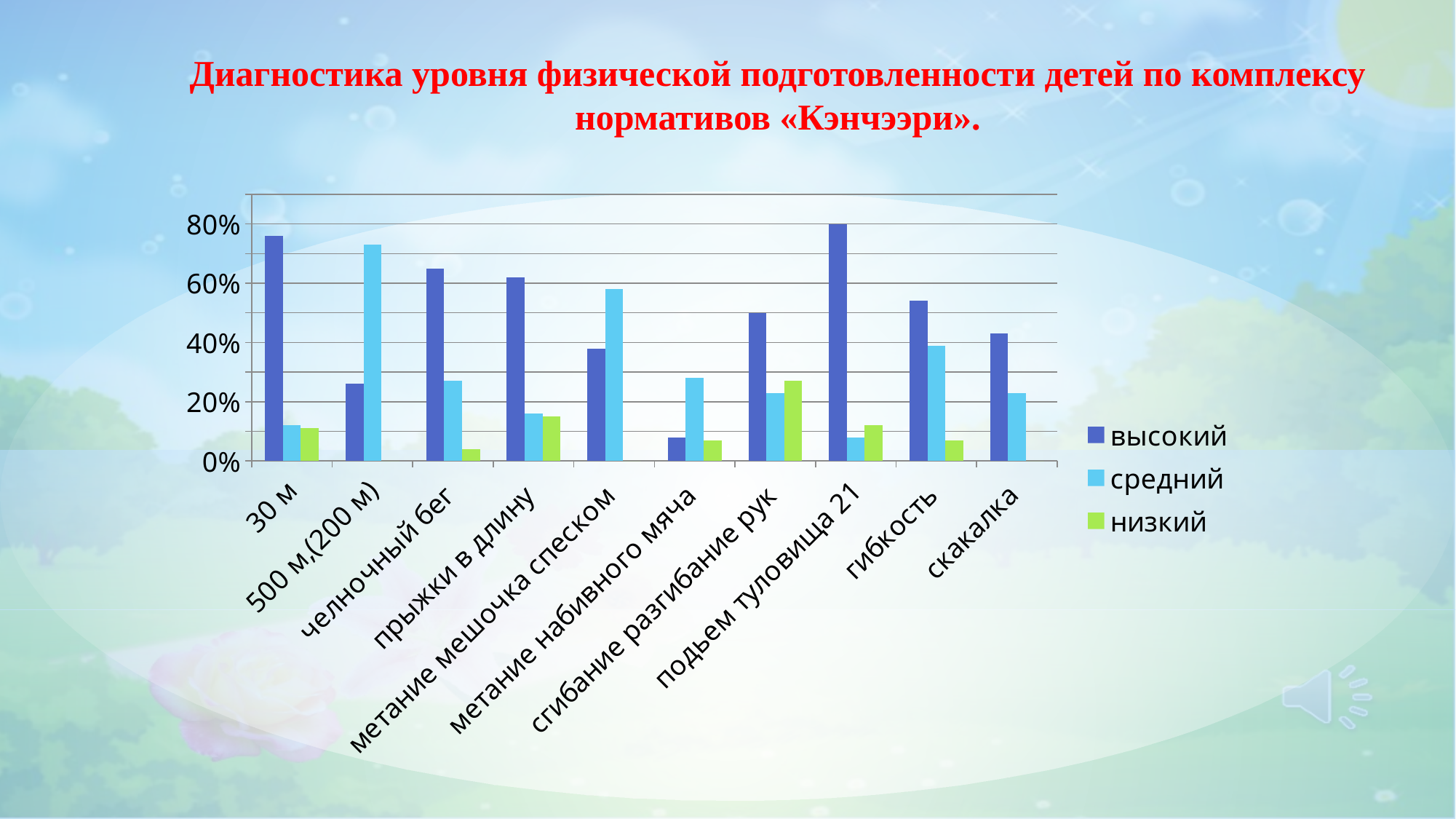
Is the высокий value for метание набивного мяча greater or less than 20%? less What kind of chart is shown on the slide? bar chart Is the низкий value for сгибание разгибание рук greater or less than 20%? greater Which legend entry is shown in green? низкий How many series does the legend list? 3 Is the высокий value for 30 м greater or less than 60%? greater How many categories are shown on the x axis? 10 For 30 м, which series has the larger value: высокий or средний? высокий For 500 м,(200 м), which series has the larger value: высокий or средний? средний Which category has the lowest value for the высокий series? метание набивного мяча Which category has the highest value for the средний series? 500 м,(200 м)